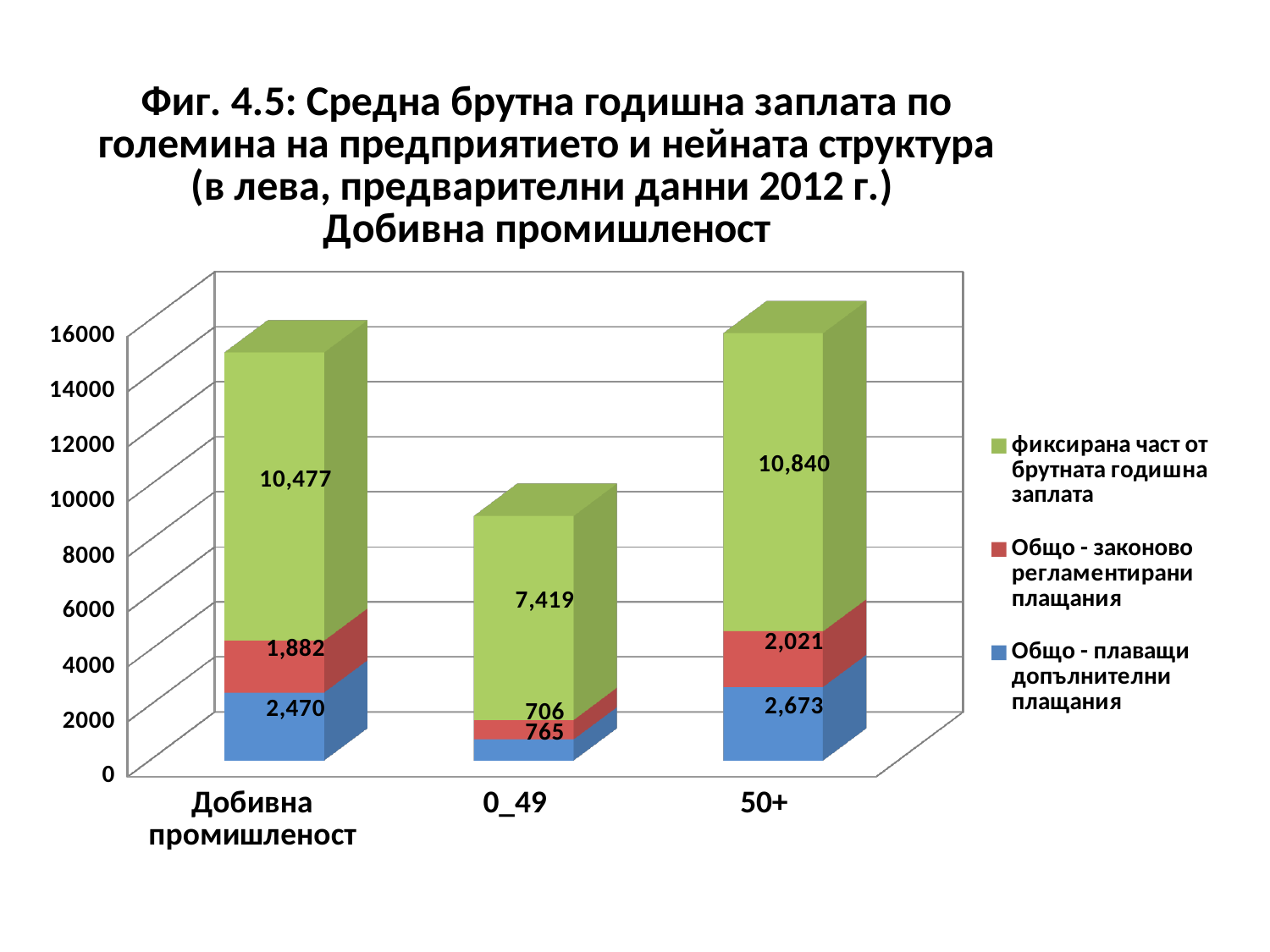
Which colour represents 'Общо - законово регламентирани плащания' in the legend? Red How many series does the legend list? 3 What is the value of 'Общо - плаващи допълнителни плащания' for 'Добивна промишленост'? 2,470 What is the total of the stacked bar for 'Добивна промишленост'? 14,829 What type of chart is shown on the slide? Stacked bar chart What is the value of 'фиксирана част от брутната годишна заплата' for the '0_49' category? 7,419 What is the value of 'Общо - законово регламентирани плащания' for the '50+' category? 2,021 Which category has the highest value for 'Общо - плаващи допълнителни плащания'? 50+ What is the value of 'фиксирана част от брутната годишна заплата' for the '50+' category? 10,840 How many categories are shown on the x axis? 3 What is the difference between the 'фиксирана част от брутната годишна заплата' values for '50+' and 'Добивна промишленост'? 363 Which category has the lowest value for 'фиксирана част от брутната годишна заплата'? 0_49